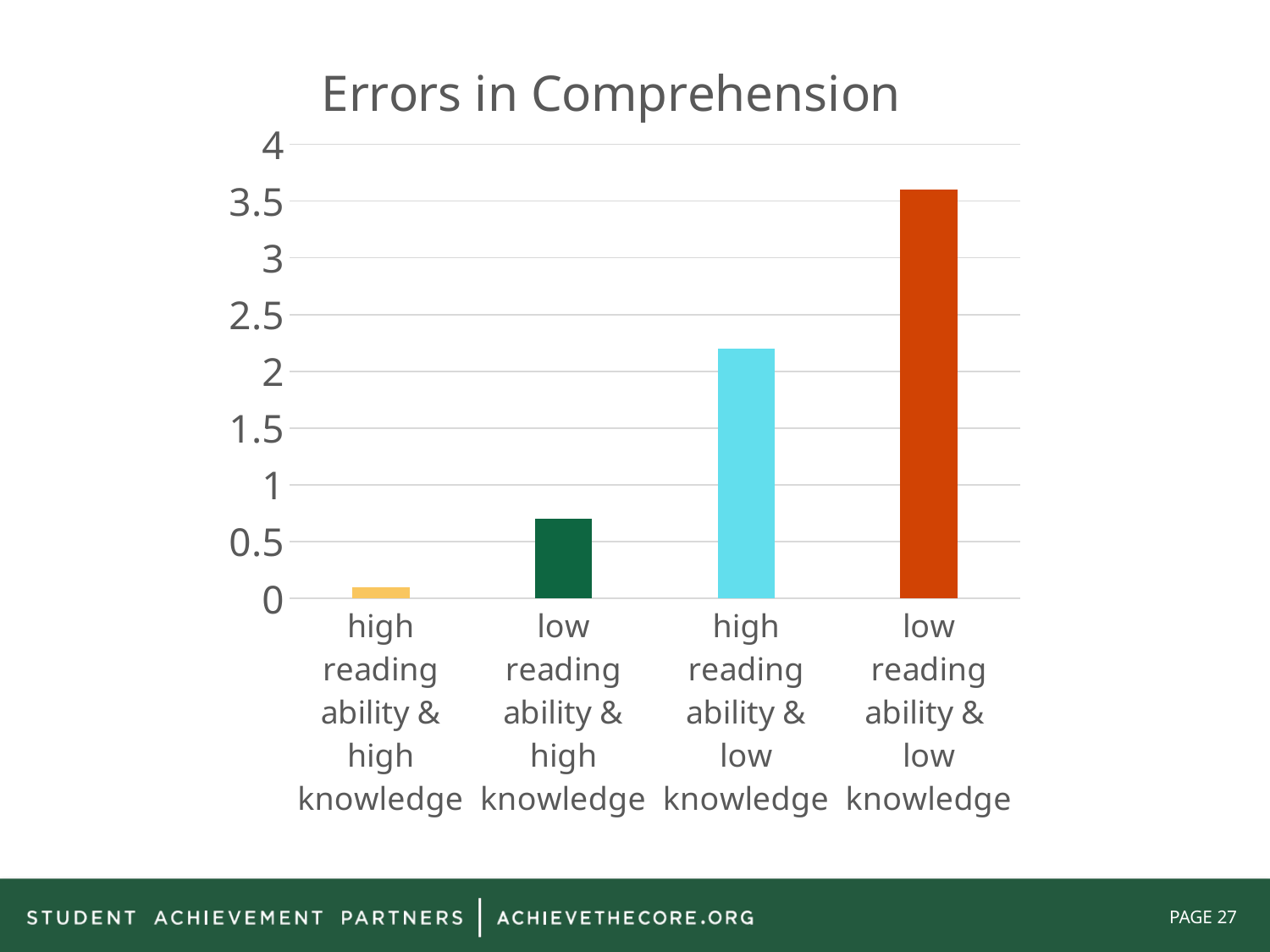
What colour is the bar for low reading ability & low knowledge? red-orange How many categories are shown on the x axis of the chart? 4 Is the value for high reading ability & high knowledge greater or less than 0.5? less Which category has the lowest value? high reading ability & high knowledge Which category has the highest value? low reading ability & low knowledge Do the values rise or fall from left to right along the x axis? rise What is the title of the chart? Errors in Comprehension Is the value for low reading ability & high knowledge greater or less than 1? less What kind of chart is shown on the slide? bar chart Which is larger: the value for low reading ability & high knowledge or the value for high reading ability & low knowledge? high reading ability & low knowledge Is the value for low reading ability & low knowledge greater or less than 3? greater